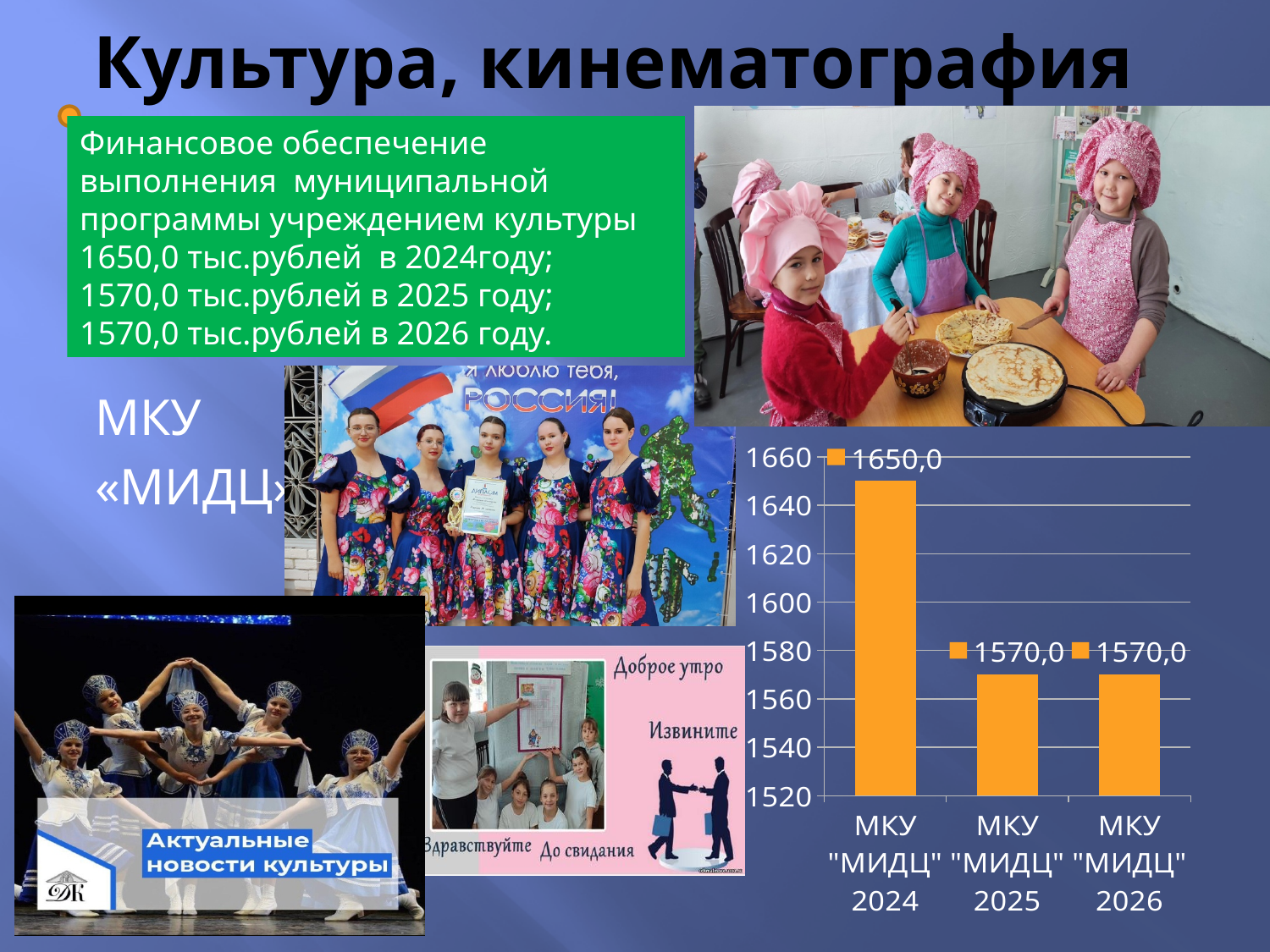
What kind of chart is shown on the slide? bar chart What is the value for МКУ "МИДЦ" 2024 in the bar chart? 1650,0 What is the difference between the values for МКУ "МИДЦ" 2024 and МКУ "МИДЦ" 2025? 80,0 What colour are the bars in the chart? orange Which is larger, the value for МКУ "МИДЦ" 2024 or the value for МКУ "МИДЦ" 2026? МКУ "МИДЦ" 2024 Which category has the highest value in the bar chart? МКУ "МИДЦ" 2024 Is the value for МКУ "МИДЦ" 2024 greater or less than 1640? greater How many bars are shown in the chart? 3 Is the value for МКУ "МИДЦ" 2025 greater or less than 1600? less What is the value for МКУ "МИДЦ" 2026 in the bar chart? 1570,0 Do the values in the chart rise or fall from 2024 to 2025? fall What is the value for МКУ "МИДЦ" 2025 in the bar chart? 1570,0